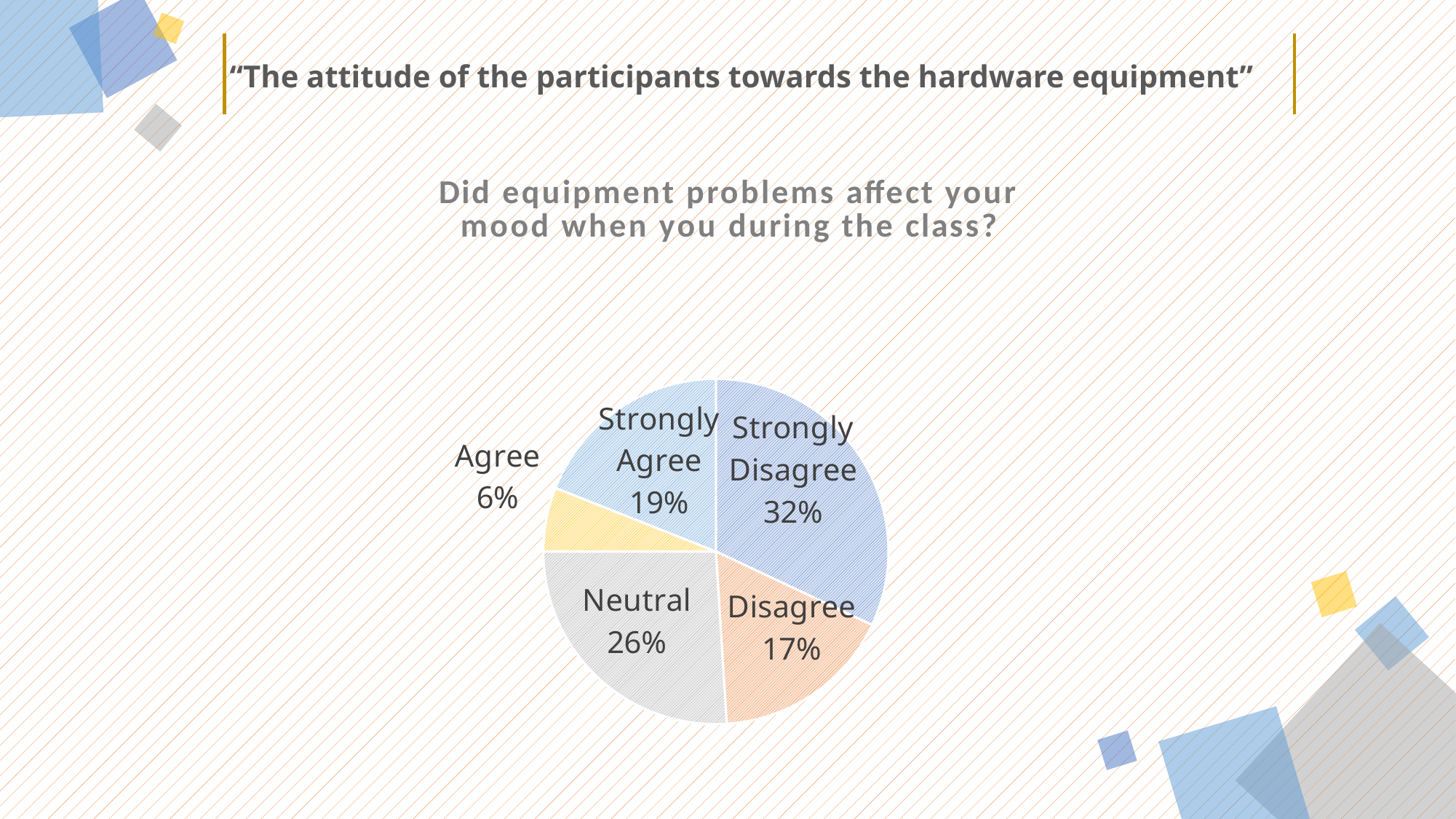
What is the difference in percentage points between Strongly Disagree and Disagree? 15 What percentage of participants answered Agree? 6% What percentage of participants answered Strongly Agree? 19% How many slices does the pie chart have? 5 What percentage of participants answered Neutral? 26% Which response has the largest share of the pie? Strongly Disagree Which is larger, the share for Neutral or the share for Strongly Agree? Neutral What is the chart's title? Did equipment problems affect your mood when you during the class? What is the combined share of Strongly Agree and Agree? 25% Which response has the smallest share of the pie? Agree What percentage of participants answered Strongly Disagree? 32% What kind of chart is shown on the slide? pie chart